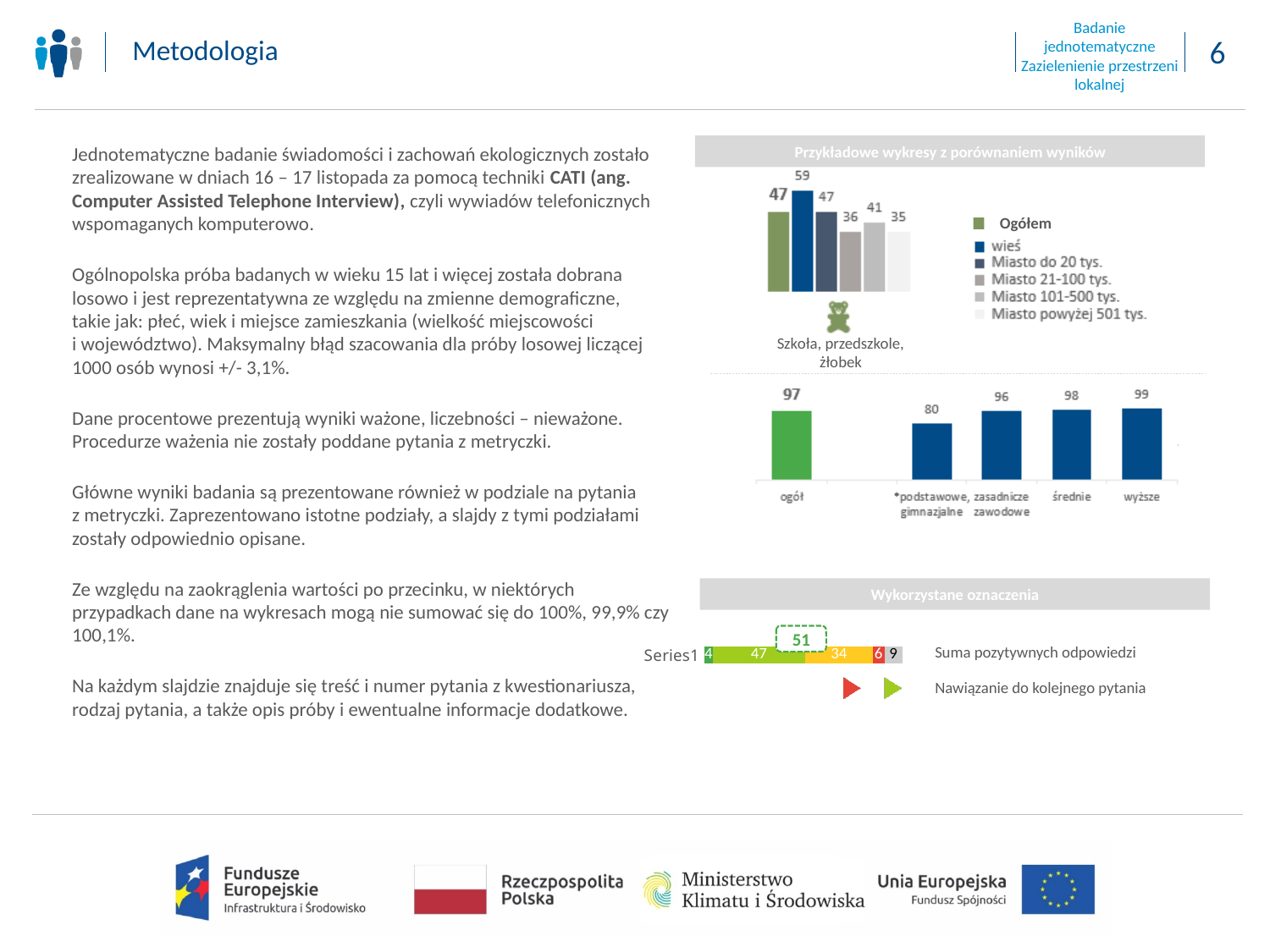
In the top-right chart (Szkoła, przedszkole, żłobek), how many categories does the legend list? 6 In the middle chart on the right, what is the difference between the values for wyższe and podstawowe, gimnazjalne? 19 In the top-right chart (Szkoła, przedszkole, żłobek), what is the difference between the values for wieś and Miasto 21-100 tys.? 23 In the middle chart on the right, what is the value for ogół? 97 In the top-right chart (Szkoła, przedszkole, żłobek), what is the value for wieś? 59 In the top-right chart (Szkoła, przedszkole, żłobek), what is the value for Ogółem? 47 What kind of chart is the middle chart on the right? bar chart In the top-right chart (Szkoła, przedszkole, żłobek), which category has the highest value? wieś In the middle chart on the right, which category has the lowest value? podstawowe, gimnazjalne In the middle chart on the right, what is the value for podstawowe, gimnazjalne? 80 In the middle chart on the right, which category has the highest value? wyższe In the top-right chart (Szkoła, przedszkole, żłobek), which category has the lowest value? Miasto powyżej 501 tys.